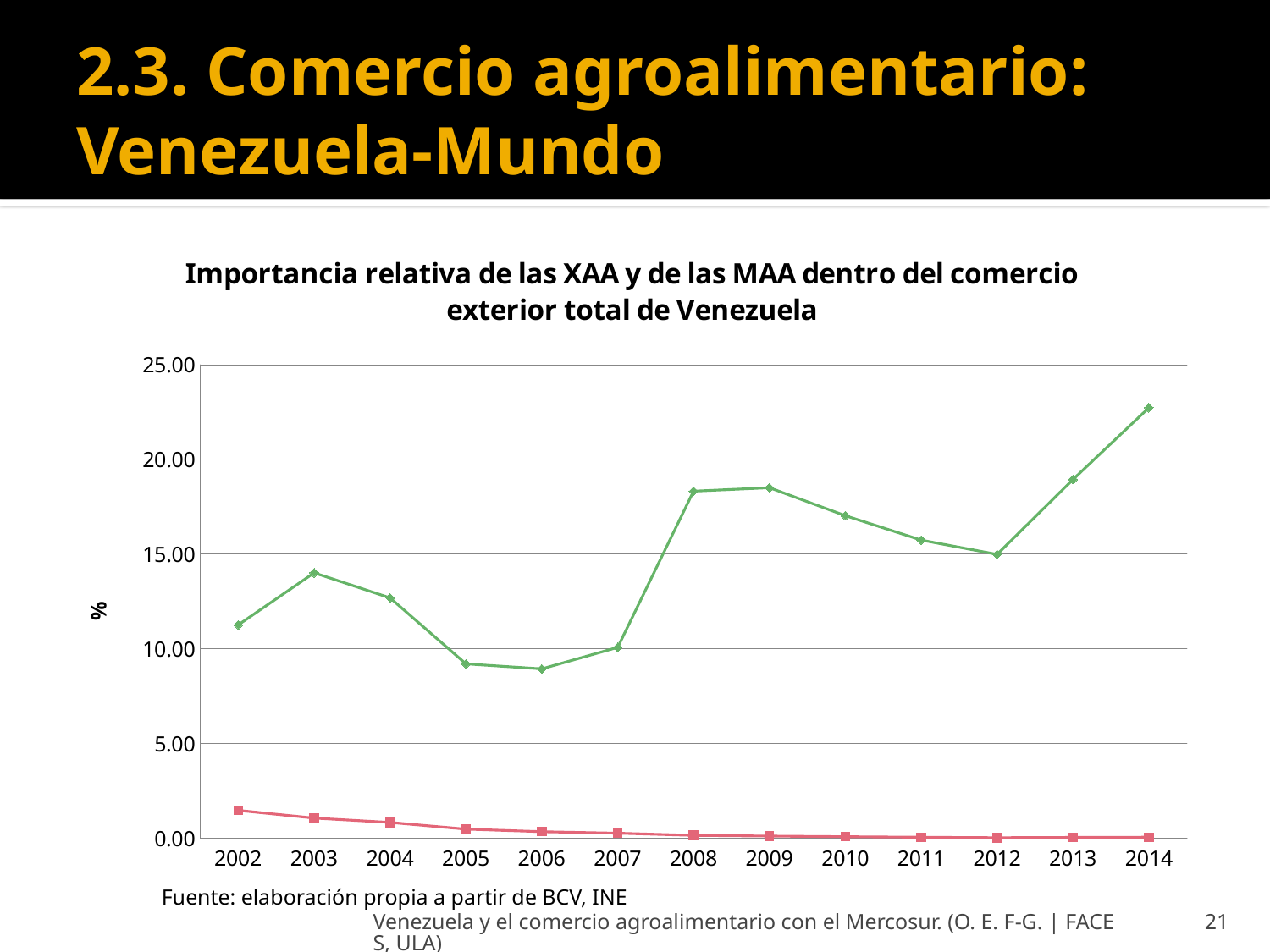
In which year does the green line reach its highest value? 2014 Is the value of the red line in 2002 greater or less than 5.00? less How many years are plotted along the x axis? 13 Is the value of the green line in 2014 greater or less than 20.00? greater Does the green line rise or fall from 2012 to 2014? rise Does the red line rise or fall from 2002 to 2014? fall Is the value of the green line in 2008 greater or less than 15.00? greater For the green line, which year has the higher value, 2003 or 2004? 2003 For the green line, which year has the higher value, 2010 or 2012? 2010 What is the label on the y axis of the chart? % What kind of chart is shown on the slide? line chart